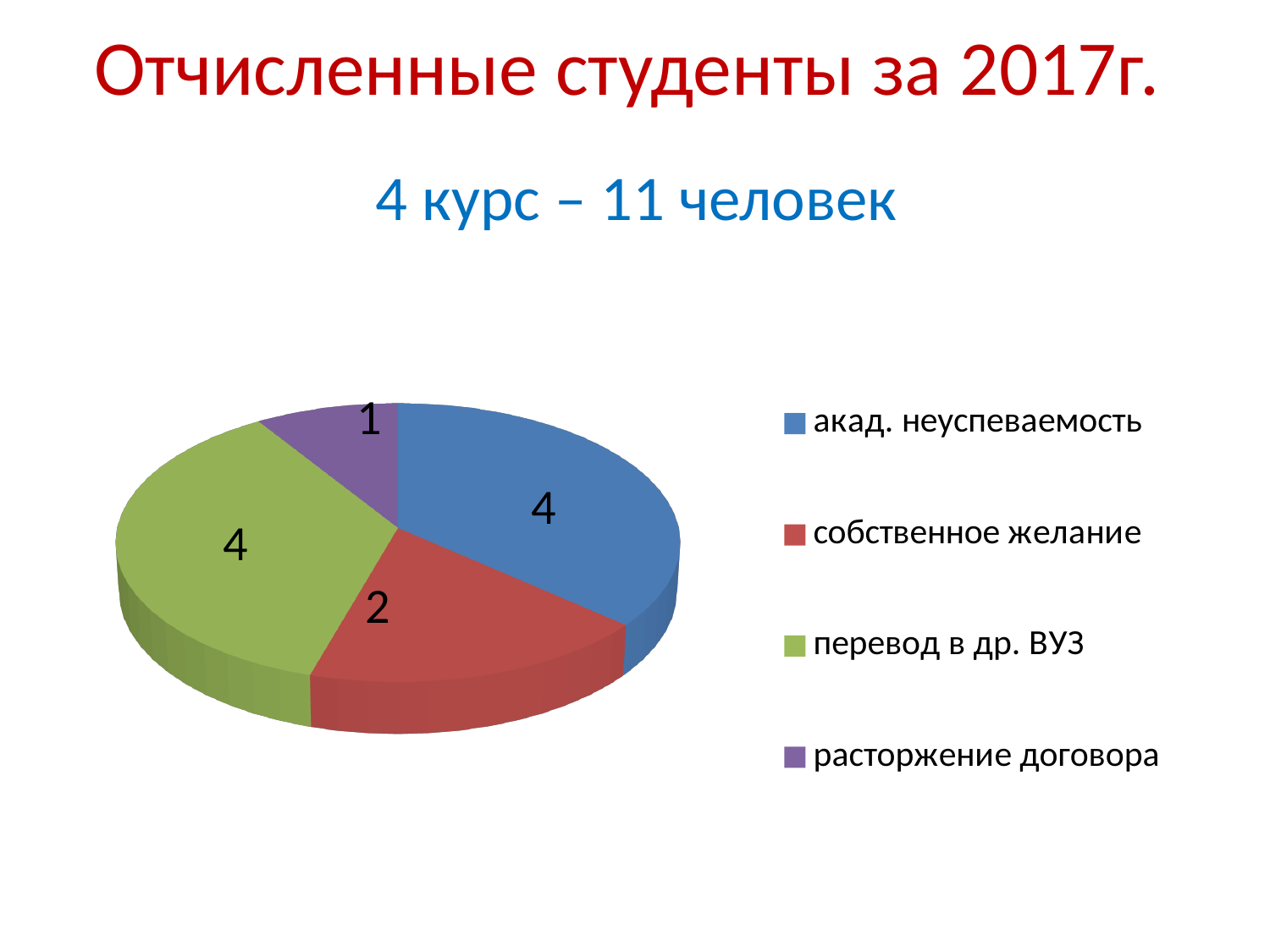
What is the value for перевод в др. ВУЗ? 4 What is the difference between the values for акад. неуспеваемость and собственное желание? 2 What is the value for акад. неуспеваемость? 4 What kind of chart is shown on the slide? pie chart Which is larger, the value for перевод в др. ВУЗ or the value for расторжение договора? перевод в др. ВУЗ What is the value for расторжение договора? 1 What is the value for собственное желание? 2 What is the difference between the values for собственное желание and расторжение договора? 1 Which is larger, the value for собственное желание or the value for акад. неуспеваемость? акад. неуспеваемость What is the total of all the slices in the pie chart? 11 Which category has the smallest slice? расторжение договора How many categories does the pie chart have? 4